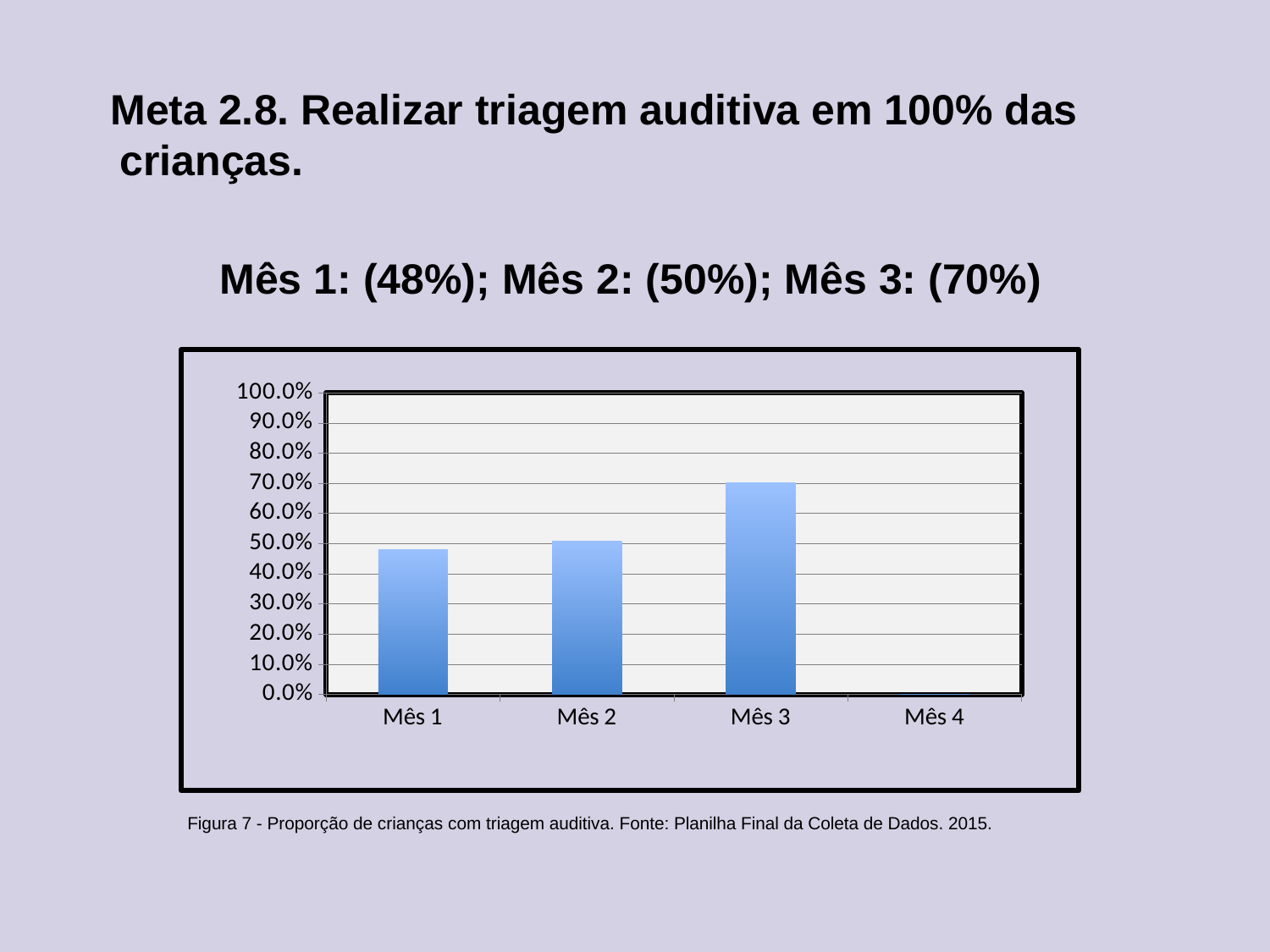
Which month has the tallest bar in the chart? Mês 3 What is the value for Mês 2? 50% What figure number is given in the caption below the chart? Figura 7 What is the highest value shown on the y axis of the chart? 100.0% Do the values rise or fall from Mês 1 to Mês 3? rise What is the value for Mês 1? 48% How many month categories are shown on the x axis of the chart? 4 What is the difference between the values for Mês 3 and Mês 1? 22% Is the value for Mês 3 greater or less than 60.0%? greater Which is larger, the value for Mês 2 or the value for Mês 3? Mês 3 What is the value for Mês 3? 70% What kind of chart is shown on the slide? bar chart